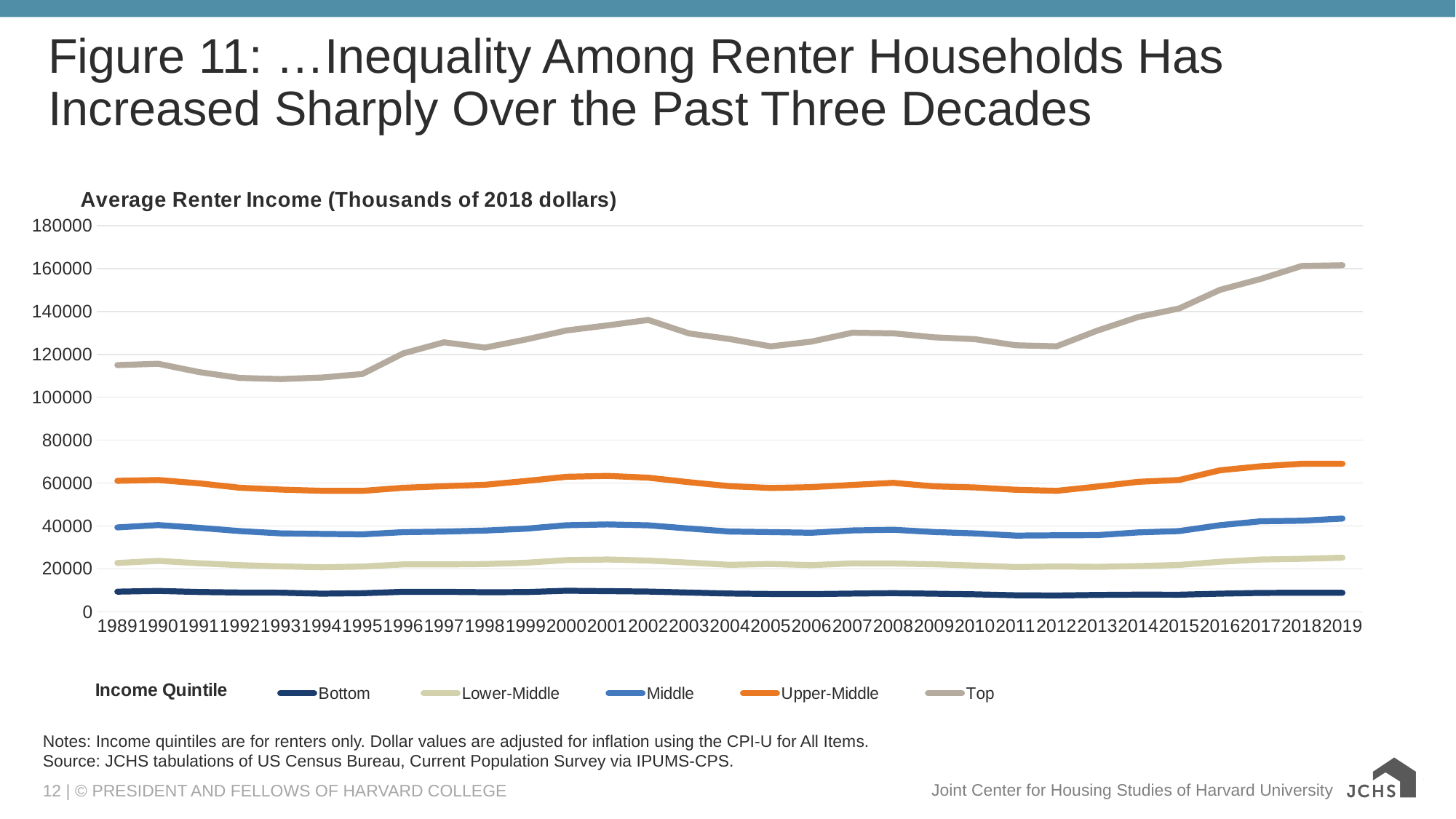
Is the value for the Top quintile in 2019 greater or less than 140000? greater How many series does the legend list? 5 Is the value for the Top quintile in 1993 greater or less than 120000? less Which income quintile has the highest average renter income across the chart? Top What is the title of the chart? Average Renter Income (Thousands of 2018 dollars) How many years are plotted along the x axis? 31 Does the Top quintile line rise or fall between 2012 and 2018? rise Is the value for the Middle quintile in 2019 greater or less than 60000? less In 2019, which is larger: the Top quintile or the Upper-Middle quintile? Top Which income quintile has the lowest average renter income across the chart? Bottom What kind of chart is shown on the slide? line chart